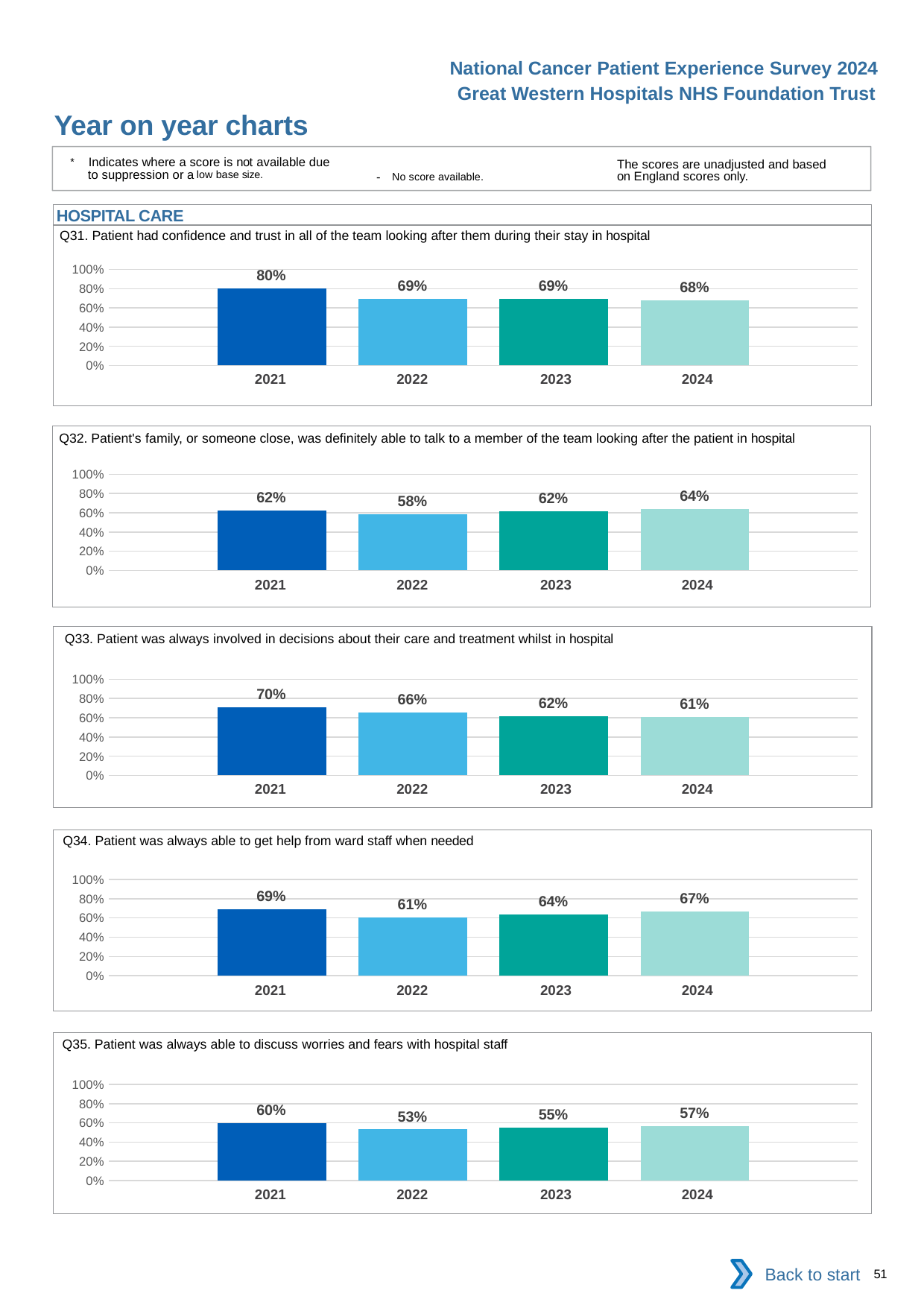
In the Q34 chart, which is larger, the value for 2022 or the value for 2024? 2024 In the Q35 chart, what is the value for 2023? 55% What is the section heading above the Q31 chart? HOSPITAL CARE In the Q33 chart, what is the difference between the 2021 and 2024 values? 9% In the Q32 chart, which year has the highest value? 2024 How many years are shown in the Q31 chart? 4 In the Q31 chart, what is the value for 2021? 80% In the Q33 chart, do the values rise or fall from 2021 to 2024? fall What kind of chart is the Q32 chart? bar chart In the Q32 chart, which year has the lowest value? 2022 In the Q34 chart, what is the value for 2023? 64% In the Q35 chart, what is the difference between the 2021 and 2022 values? 7%